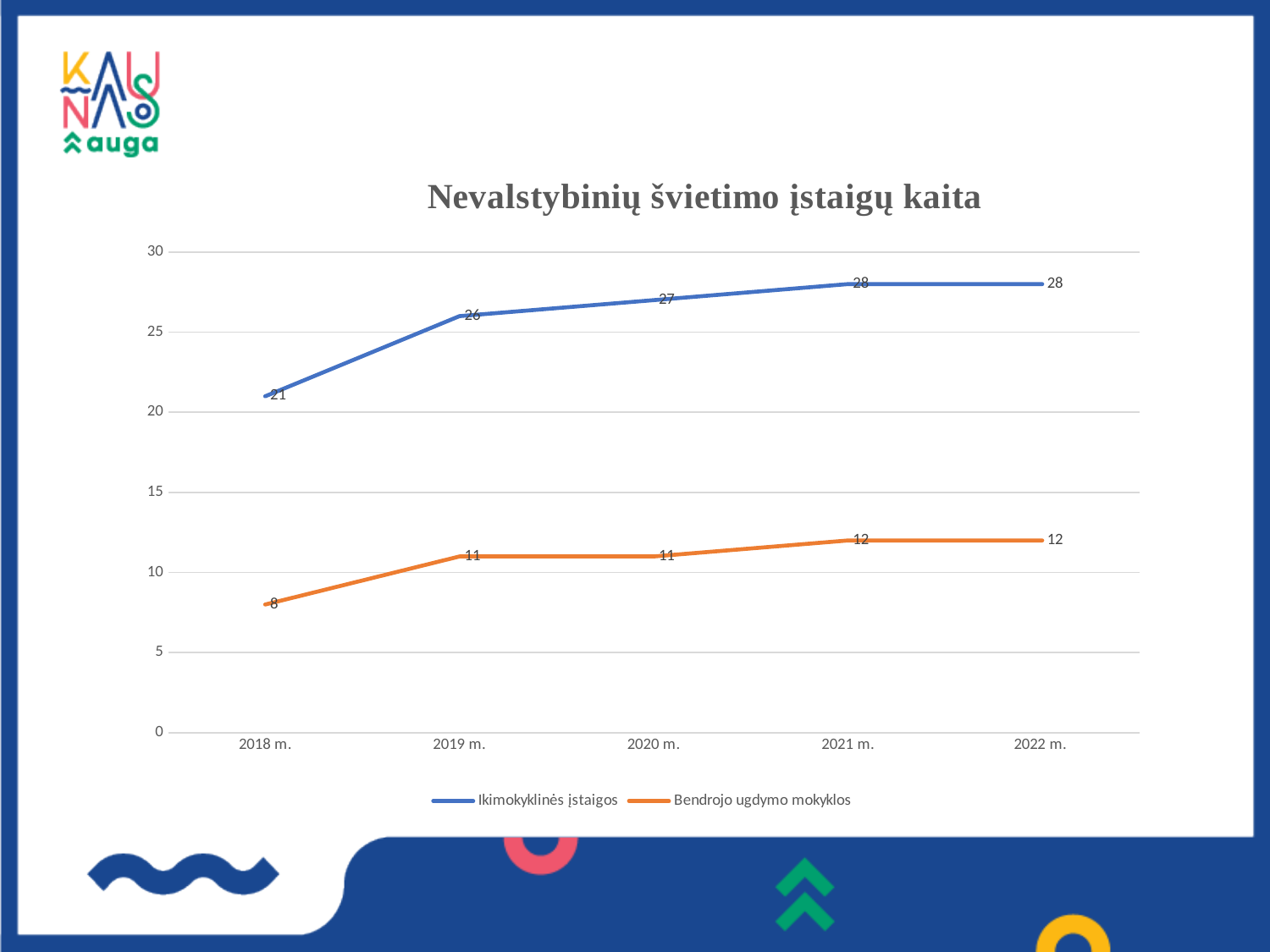
What is the value for Ikimokyklinės įstaigos in 2018 m.? 21 What is the title of the chart? Nevalstybinių švietimo įstaigų kaita By how much did Ikimokyklinės įstaigos increase from 2018 m. to 2019 m.? 5 What kind of chart is shown on the slide? line chart How many years are shown on the x axis? 5 What is the value for Ikimokyklinės įstaigos in 2022 m.? 28 Which series has the higher value in 2019 m., Ikimokyklinės įstaigos or Bendrojo ugdymo mokyklos? Ikimokyklinės įstaigos In which year is the value for Bendrojo ugdymo mokyklos lowest? 2018 m. What is the difference between Ikimokyklinės įstaigos and Bendrojo ugdymo mokyklos in 2021 m.? 16 Is the value for Ikimokyklinės įstaigos in 2020 m. greater or less than 25? greater What is the value for Bendrojo ugdymo mokyklos in 2020 m.? 11 How many series does the legend list? 2